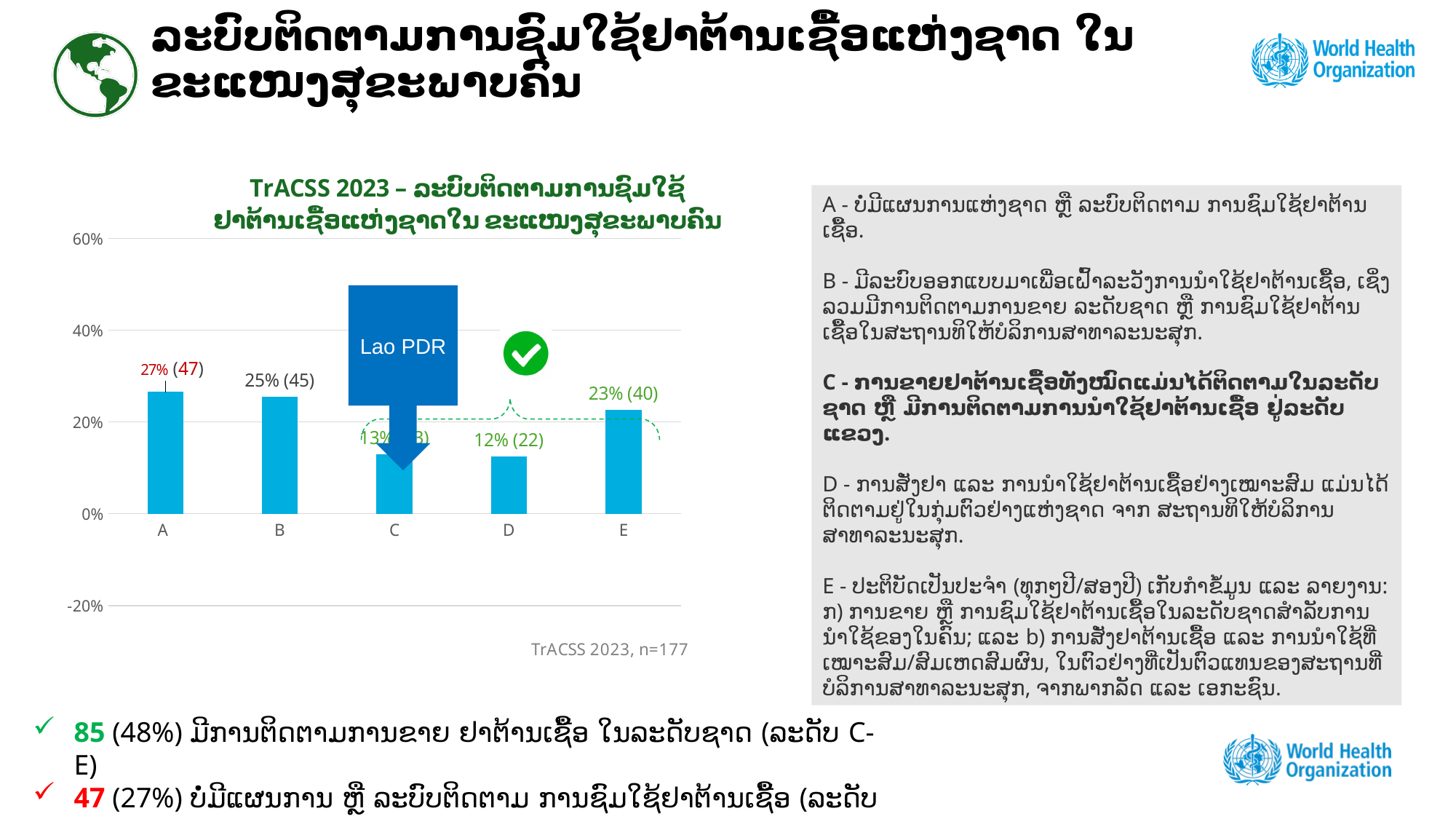
What is the value shown for category B? 25% (45) What kind of chart is shown on the slide? bar chart Is the value for category C greater or less than 20%? less Which category has the highest value? A Which category has the lowest value? D How many categories are shown on the x axis? 5 Which category is marked with the 'Lao PDR' arrow? C What is the value shown for category E? 23% (40) What is the value shown for category A? 27% (47) How many more responses (count in parentheses) does category A have than category B? 2 Which is larger, the value for B or the value for E? B What is the value shown for category D? 12% (22)